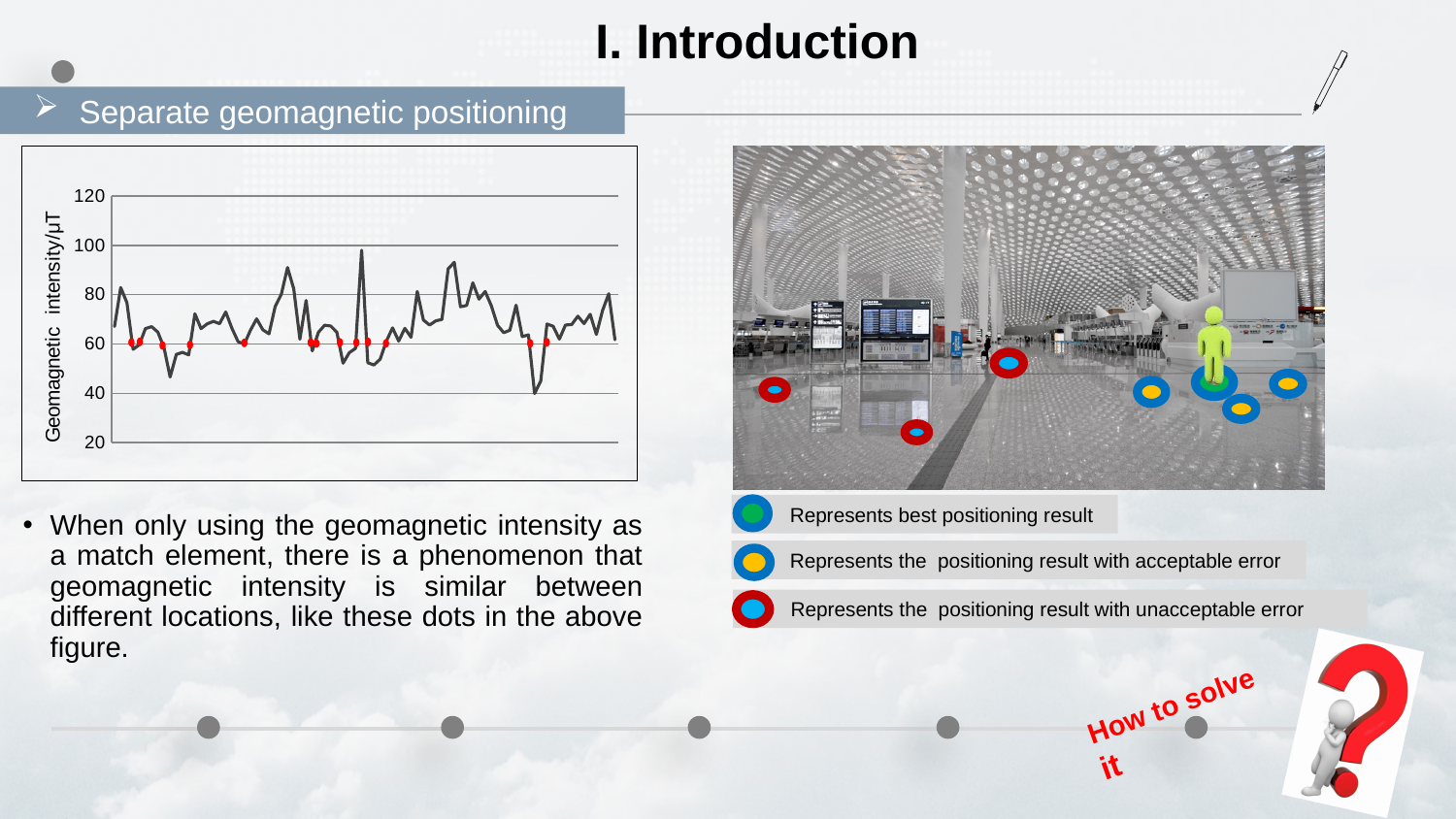
Near which y-axis value are the red dots on the chart placed? 60 What is the lowest value shown on the chart's y-axis? 20 What kind of chart is shown on the left of the slide? line chart How many tick values are labelled on the chart's y-axis? 6 What is the label of the y-axis on the chart? Geomagnetic intensity/μT What is the highest value shown on the chart's y-axis? 120 What colour are the highlighted dots on the line chart? red Is the lowest point of the line on the chart greater or less than 60? less Is the highest point of the line on the chart greater or less than 80? greater